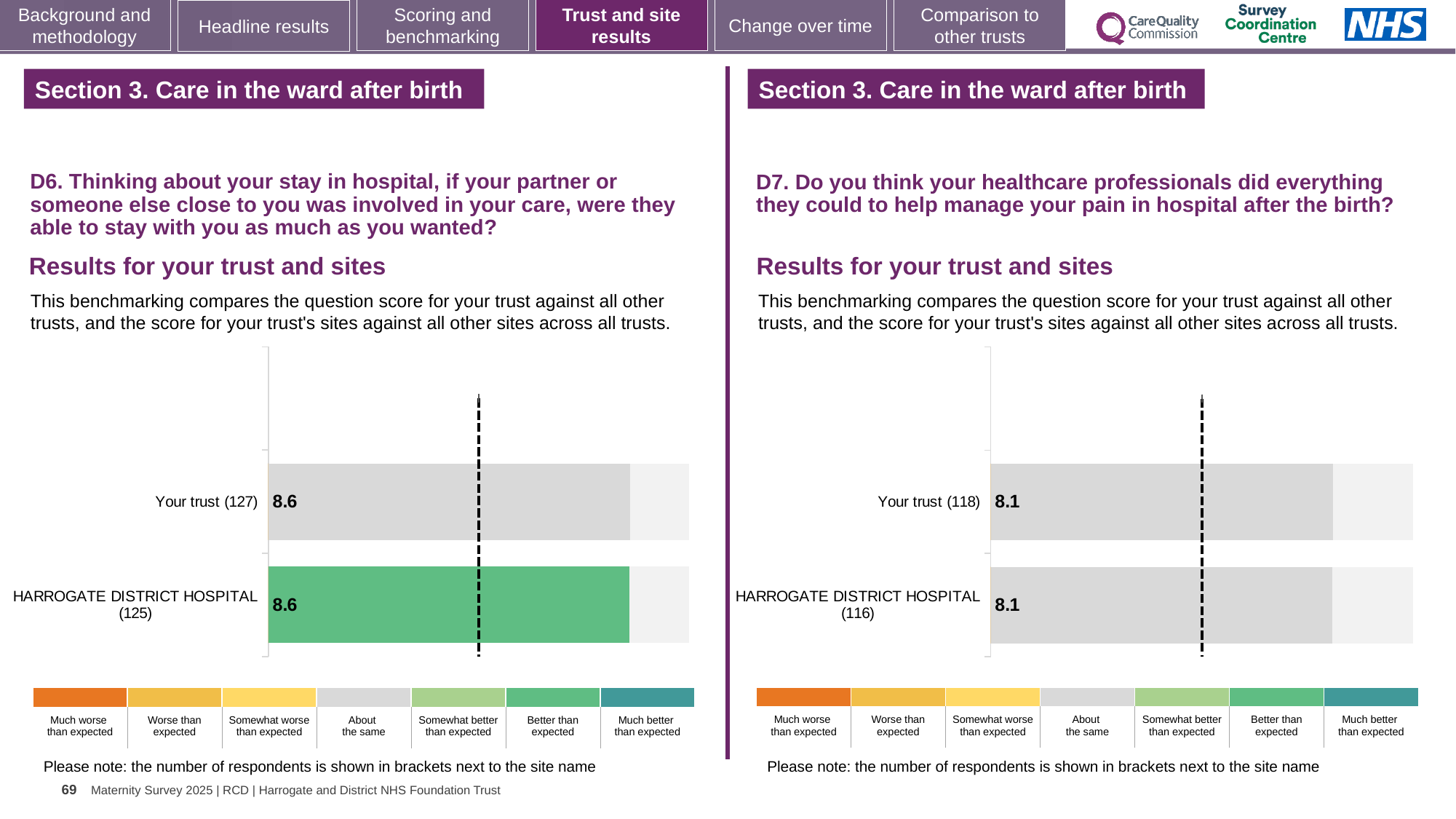
In the D7 chart on the right, what is the score for HARROGATE DISTRICT HOSPITAL? 8.1 In the D6 chart on the left, what is the difference between the Your trust score and the HARROGATE DISTRICT HOSPITAL score? 0 In the D7 chart on the right, how many respondents are shown in brackets for Your trust? 118 What kind of chart is used for the D6 results on the left? Bar chart In the D6 chart on the left, what is the score for HARROGATE DISTRICT HOSPITAL? 8.6 In the D7 chart on the right, what is the score for Your trust? 8.1 How many bars are plotted in the D6 chart on the left? 2 How many benchmark categories does the legend below the D7 chart on the right list? 7 In the D6 chart on the left, what is the score for Your trust? 8.6 How many bars are plotted in the D7 chart on the right? 2 In the D6 chart on the left, how many respondents are shown in brackets for HARROGATE DISTRICT HOSPITAL? 125 In the D6 chart on the left, which benchmark category does the green colour of the HARROGATE DISTRICT HOSPITAL bar correspond to in the legend? Better than expected